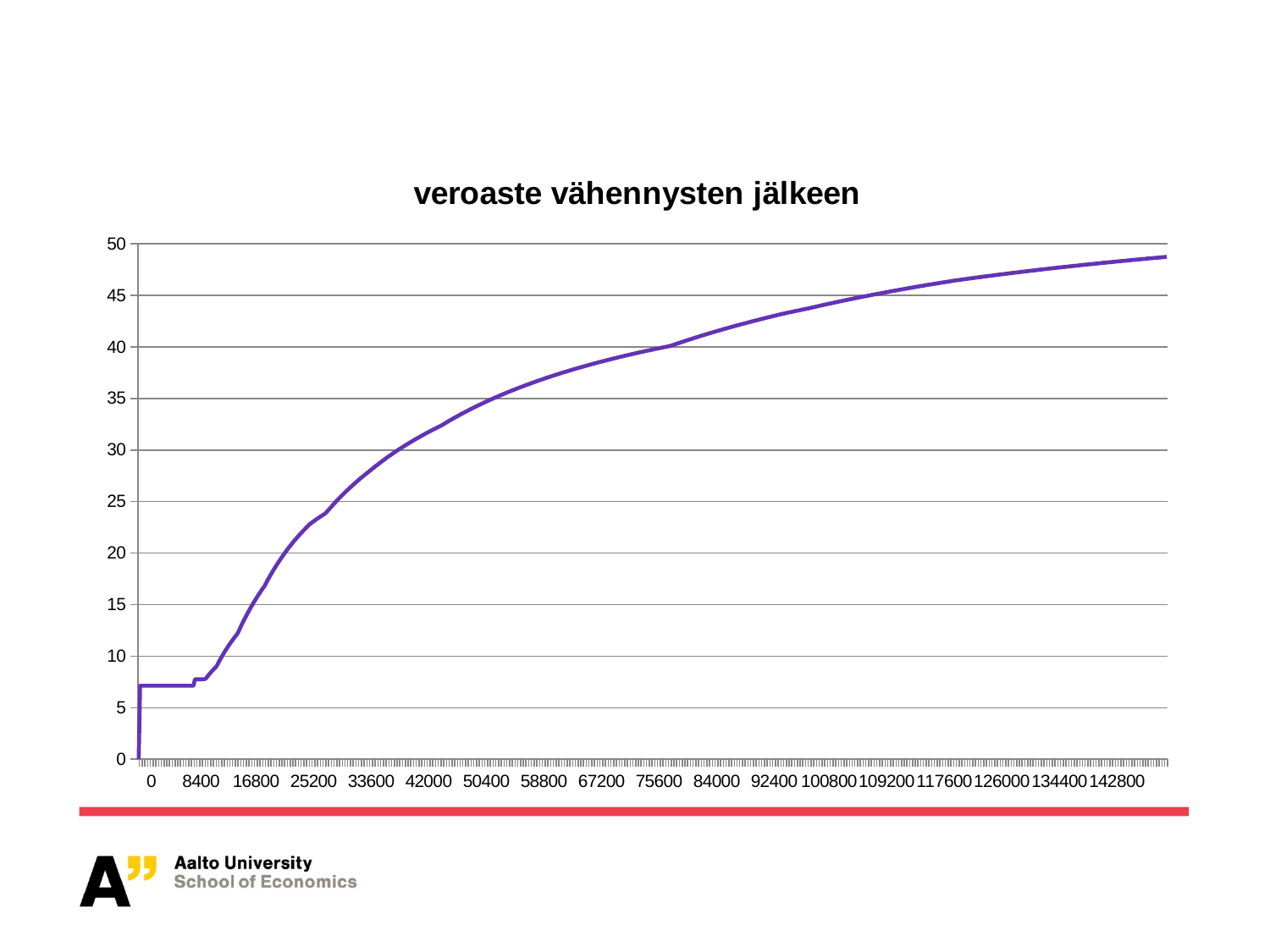
Is the value at x = 100800 greater or less than 40? greater What kind of chart is shown on the slide? line chart What colour is the plotted line? purple Is the value at x = 8400 greater or less than 10? less Is the value at x = 142800 greater or less than 45? greater What is the title of the chart? veroaste vähennysten jälkeen Do the values generally rise or fall as the x axis increases? rise